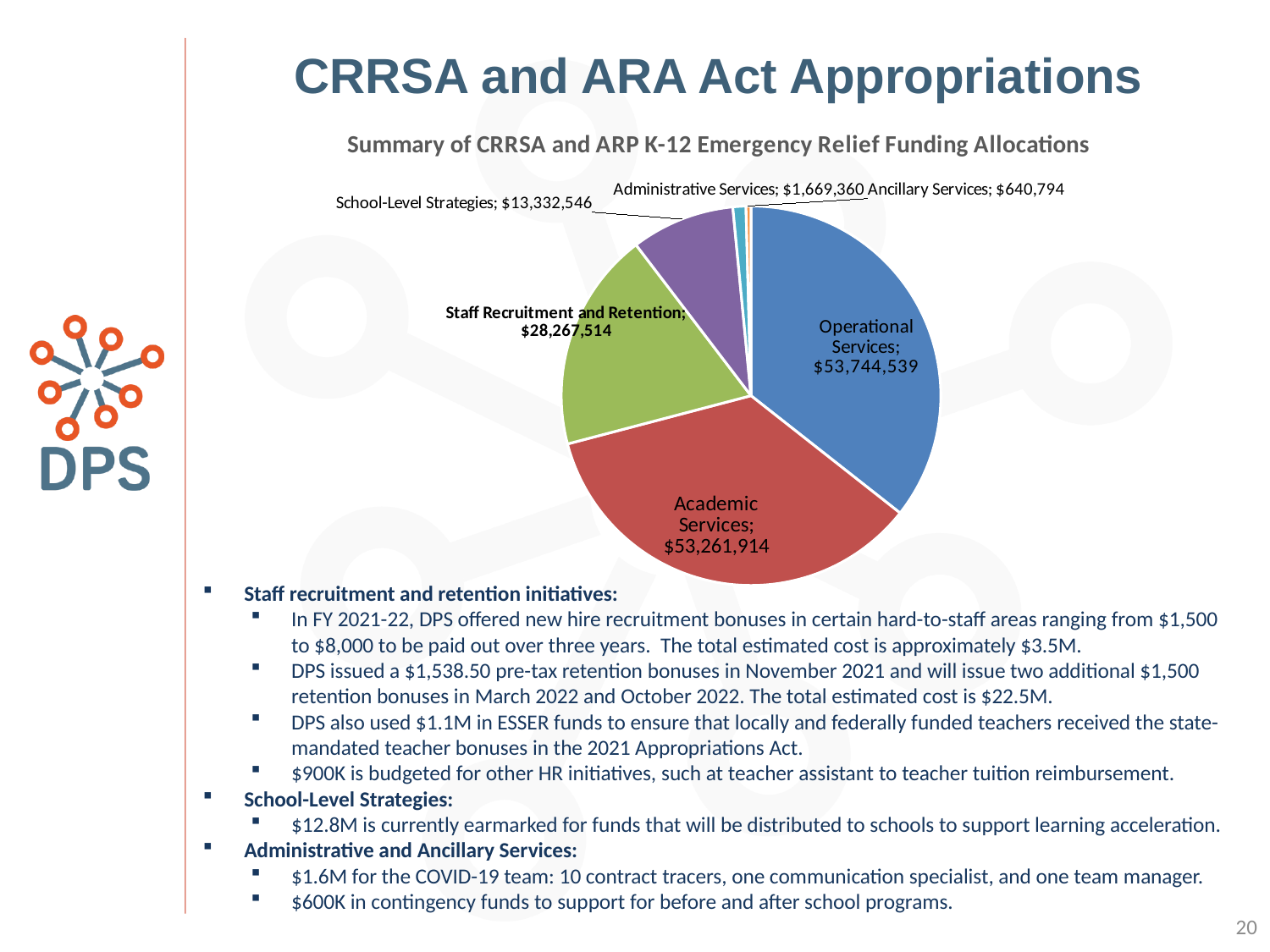
How many categories does the pie chart show? 6 Which is larger, Administrative Services or Ancillary Services? Administrative Services What is the value for Academic Services? $53,261,914 What is the difference between Operational Services and Academic Services? $482,625 What is the value for Ancillary Services? $640,794 What is the value for Staff Recruitment and Retention? $28,267,514 Which category has the largest allocation? Operational Services Which category has the smallest allocation? Ancillary Services What is the value for School-Level Strategies? $13,332,546 What is the value for Operational Services? $53,744,539 What type of chart is shown on the slide? Pie chart What is the title of the chart? Summary of CRRSA and ARP K-12 Emergency Relief Funding Allocations